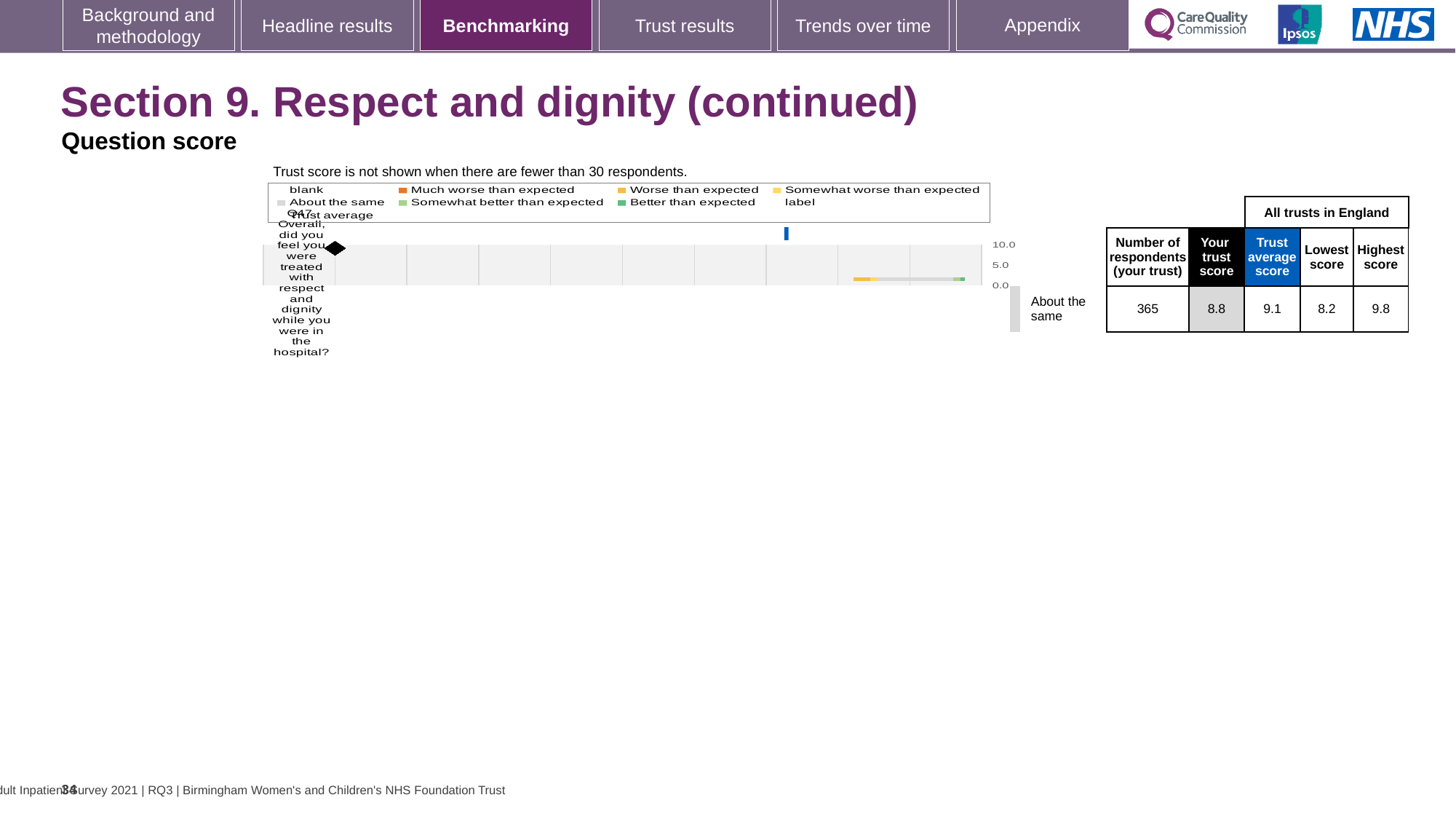
What is the number of respondents for your trust for Q47? 365 What is your trust score for Q47? 8.8 What is the difference between the highest score and the lowest score among all trusts in England for Q47? 1.6 What is the trust average score for Q47 across all trusts in England? 9.1 Which question number is plotted on the benchmarking chart? Q47 How is the trust's result for Q47 categorised relative to other trusts, according to the label beside the chart? About the same What kind of chart is used to show the benchmarking result for Q47? bar chart Is your trust score for Q47 greater or less than 5.0? greater What is the highest value shown on the chart's vertical axis? 10.0 What is the lowest score among all trusts in England for Q47? 8.2 Which is larger for Q47: your trust score or the trust average score? Trust average score What is the highest score among all trusts in England for Q47? 9.8